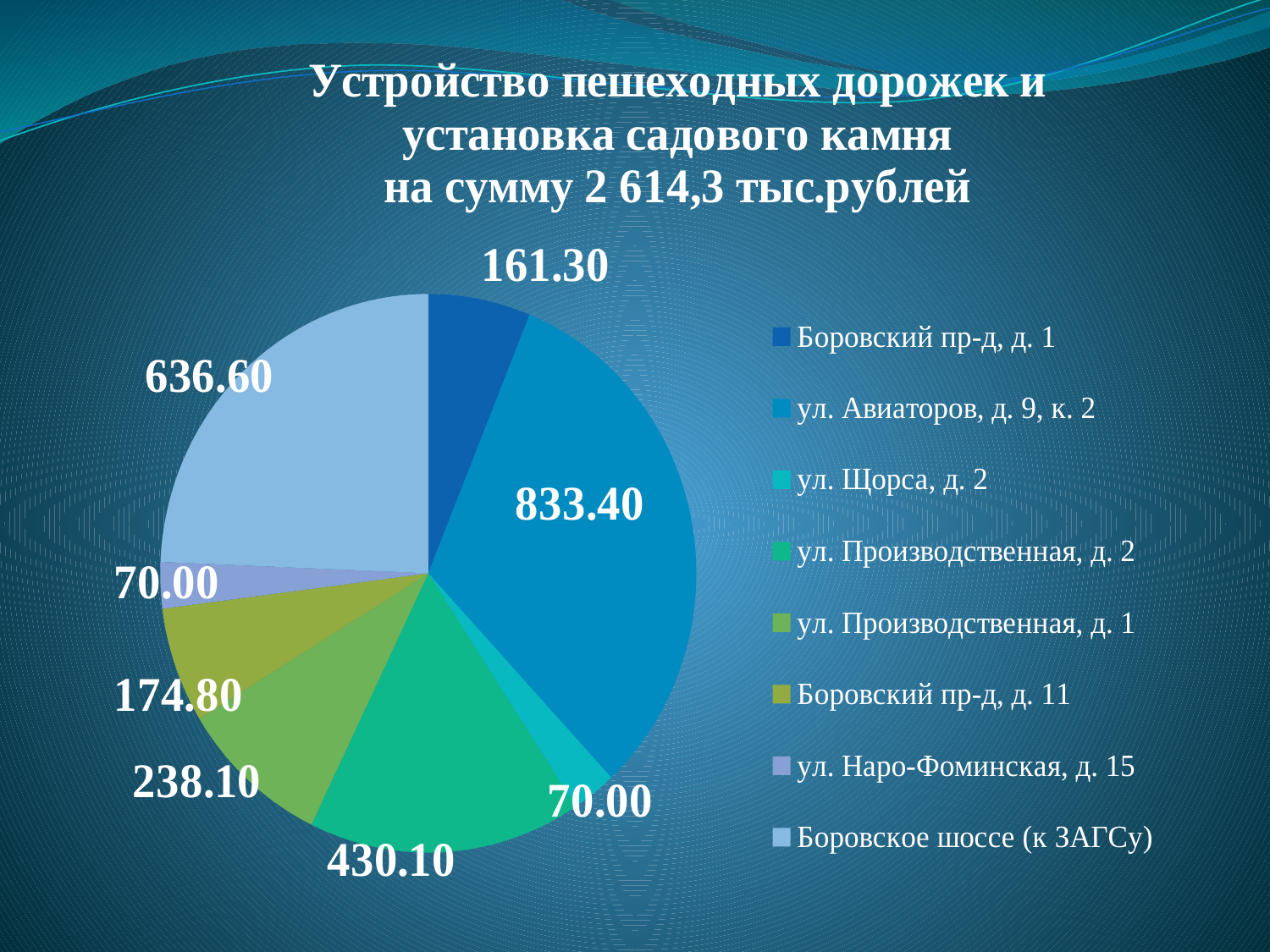
What is the value for ул. Авиаторов, д. 9, к. 2? 833.40 How many slices does the pie chart have? 8 Which category has the largest slice of the pie? ул. Авиаторов, д. 9, к. 2 What is the value for Боровское шоссе (к ЗАГСу)? 636.60 Which is larger: the value for ул. Производственная, д. 1 or the value for Боровский пр-д, д. 1? ул. Производственная, д. 1 Which legend entry is shown in the lightest blue colour? Боровское шоссе (к ЗАГСу) What is the value for Боровский пр-д, д. 11? 174.80 What total sum in thousand rubles is stated in the chart title? 2 614,3 тыс.рублей What is the difference between the values for ул. Авиаторов, д. 9, к. 2 and Боровское шоссе (к ЗАГСу)? 196.80 What is the value for ул. Производственная, д. 2? 430.10 What is the smallest value shown on the pie chart? 70.00 What kind of chart is shown on the slide? pie chart